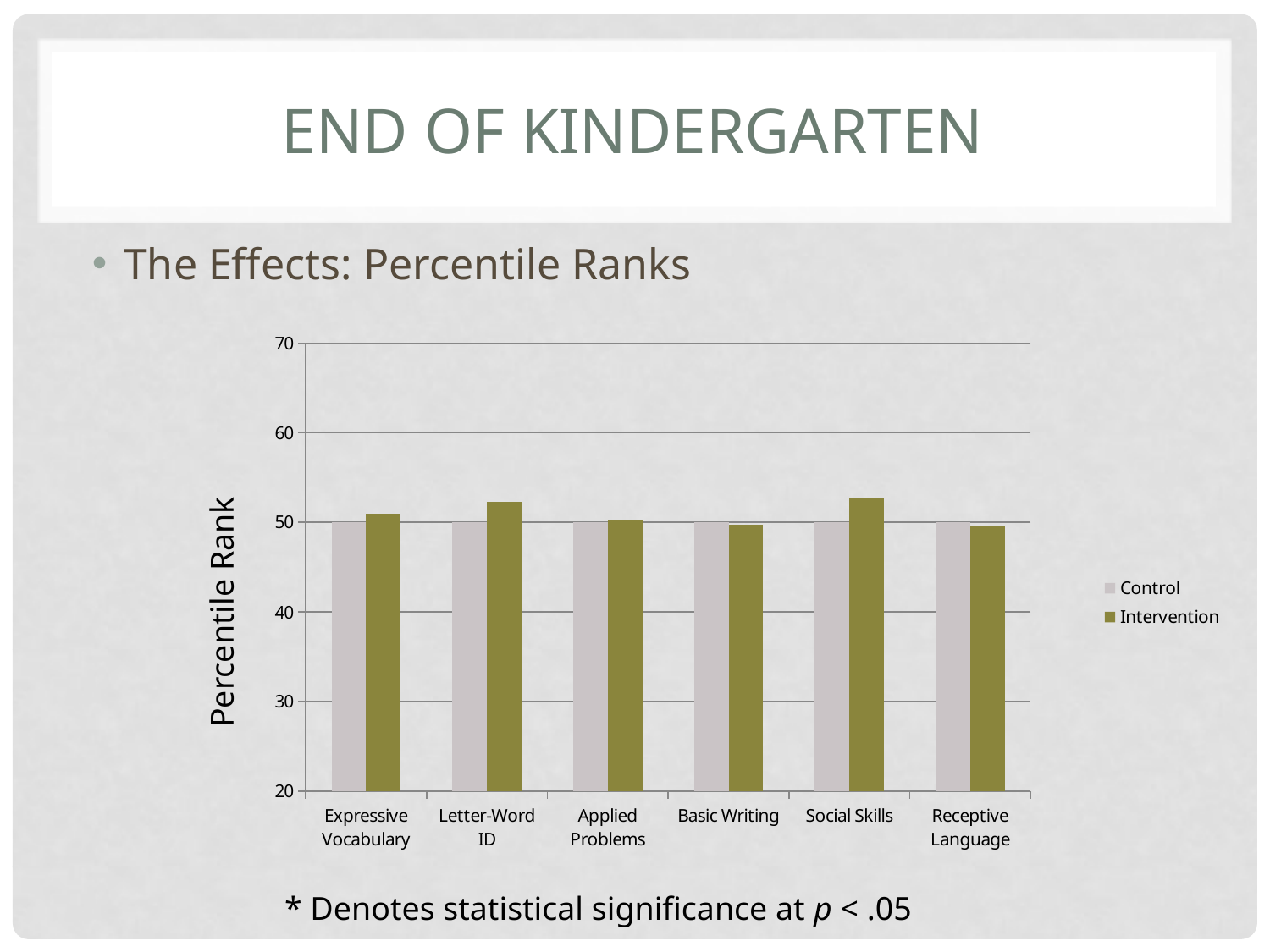
How many series does the chart's legend list? 2 What is the label on the vertical axis of the chart? Percentile Rank For Social Skills, which is larger: the Control bar or the Intervention bar? Intervention How many categories are shown along the x axis of the chart? 6 Is the Intervention value for Expressive Vocabulary greater or less than 40? greater Is the Intervention value for Social Skills greater or less than 50? greater What is the Control percentile rank for Social Skills? 50 Is the Intervention value for Letter-Word ID greater or less than 60? less What is the Control percentile rank for Letter-Word ID? 50 For Letter-Word ID, which is larger: the Control bar or the Intervention bar? Intervention What kind of chart is shown on the slide? Bar chart Which series is shown in green in the chart's legend? Intervention